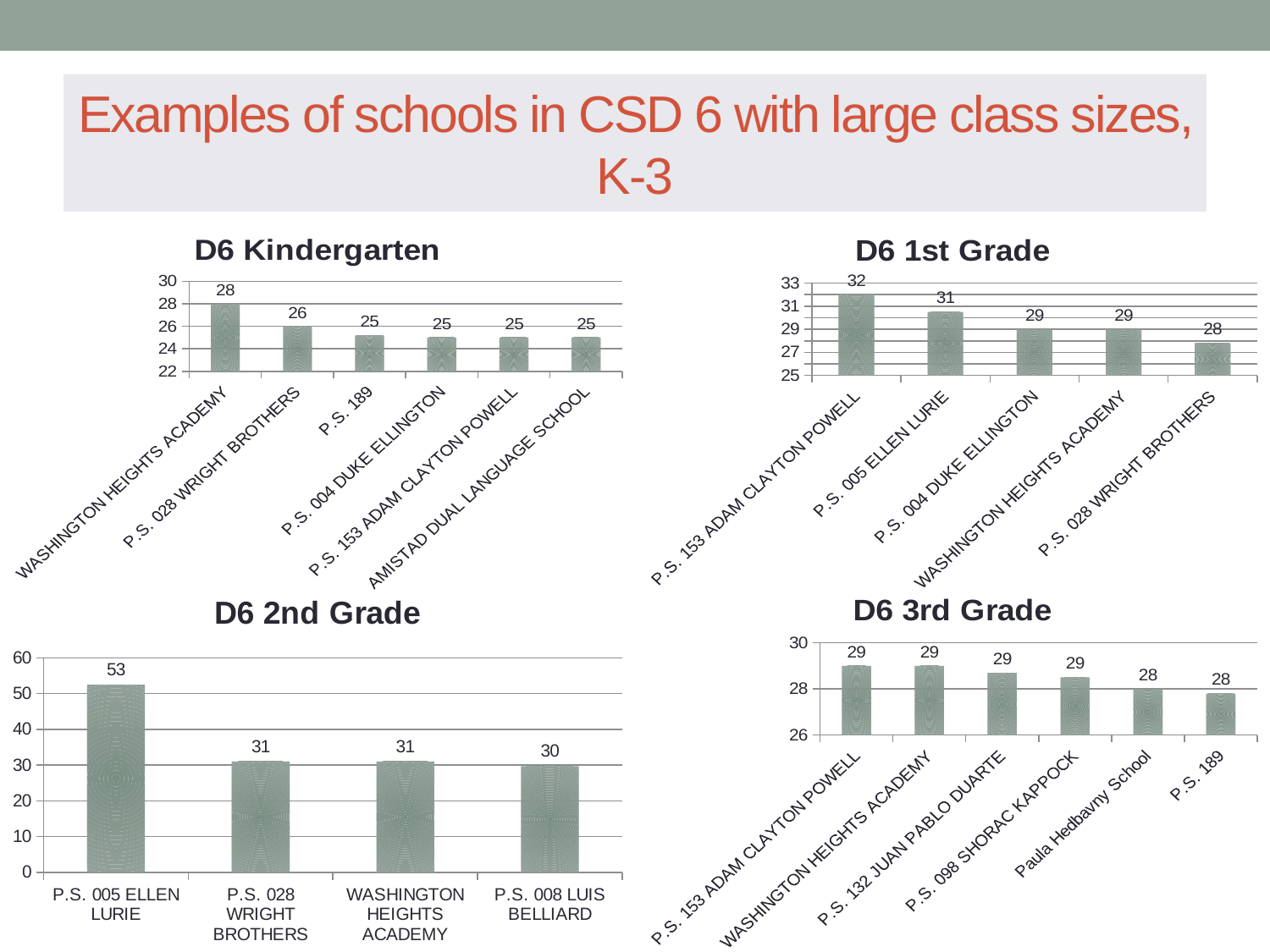
In the D6 1st Grade chart, what is the difference between P.S. 153 ADAM CLAYTON POWELL and P.S. 028 WRIGHT BROTHERS? 4 In the D6 Kindergarten chart, how many schools are shown? 6 In the D6 Kindergarten chart, what is the value for WASHINGTON HEIGHTS ACADEMY? 28 In the D6 2nd Grade chart, how many schools are shown? 4 In the D6 1st Grade chart, what is the value for P.S. 005 ELLEN LURIE? 31 In the D6 3rd Grade chart, what is the value for Paula Hedbavny School? 28 What type of chart is the D6 2nd Grade chart? bar chart In the D6 1st Grade chart, which school has the lowest value? P.S. 028 WRIGHT BROTHERS In the D6 2nd Grade chart, what is the difference between P.S. 005 ELLEN LURIE and P.S. 008 LUIS BELLIARD? 23 In the D6 Kindergarten chart, which school has the highest value? WASHINGTON HEIGHTS ACADEMY In the D6 2nd Grade chart, what is the value for P.S. 005 ELLEN LURIE? 53 In the D6 3rd Grade chart, is the value for P.S. 189 greater or less than 26? greater